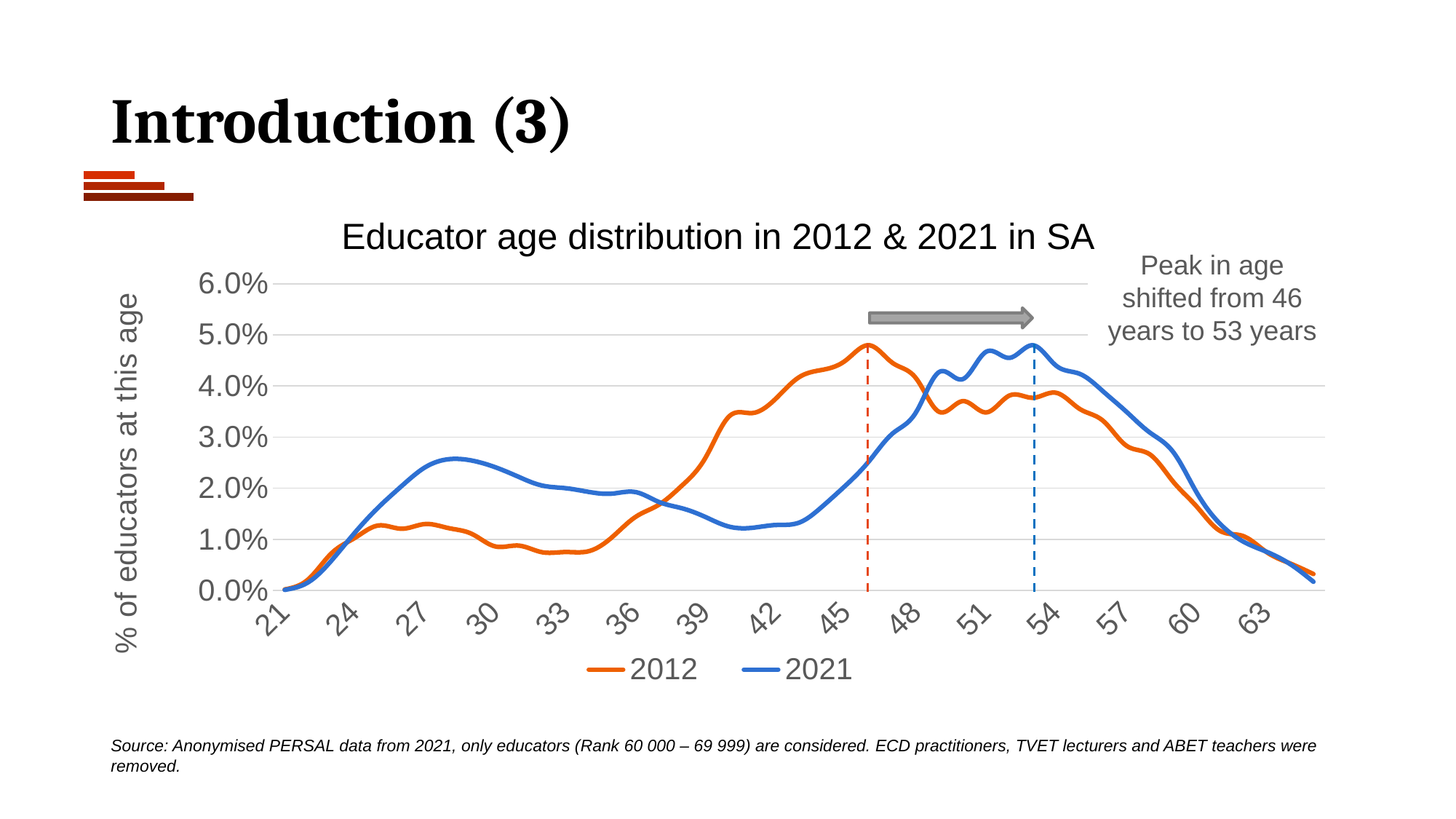
How many series does the legend list? 2 Is the value for the 2021 series at age 42 greater or less than 2.0%? less At which age does the 2012 series reach its peak? 46 years What kind of chart is shown on the slide? Line chart Is the value for the 2021 series at age 30 greater or less than 2.0%? greater Do the values of both series rise or fall between age 54 and age 63? fall At age 30, which series has the higher value, 2012 or 2021? 2021 What are the two series named in the legend? 2012 and 2021 What is the title of the chart? Educator age distribution in 2012 & 2021 in SA Is the value for the 2012 series at age 46 greater or less than 4.0%? greater At which age does the 2021 series reach its peak? 53 years At age 42, which series has the higher value, 2012 or 2021? 2012